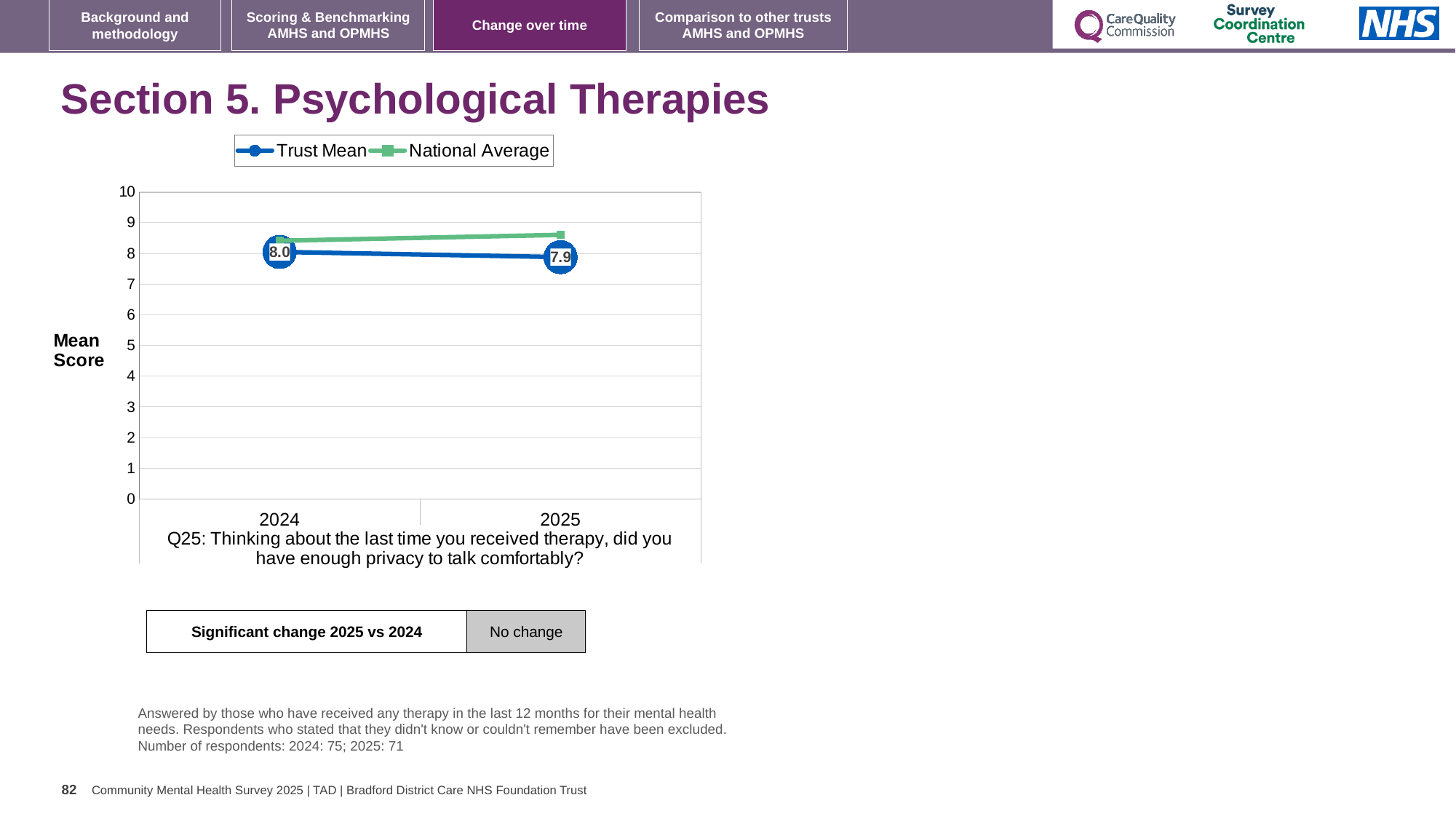
In 2025, which is higher: the Trust Mean or the National Average? National Average How many series does the legend list? 2 Is the National Average value for 2025 greater or less than 8? greater By how much did the Trust Mean score change from 2024 to 2025? 0.1 In which year is the Trust Mean score higher? 2024 What is the Trust Mean score for 2024? 8.0 Is the National Average value for 2024 greater or less than 9? less How many years are plotted on the x axis? 2 What is the Trust Mean score for 2025? 7.9 What type of chart is shown on the slide? line chart Does the National Average rise or fall from 2024 to 2025? rise Does the Trust Mean rise or fall from 2024 to 2025? fall